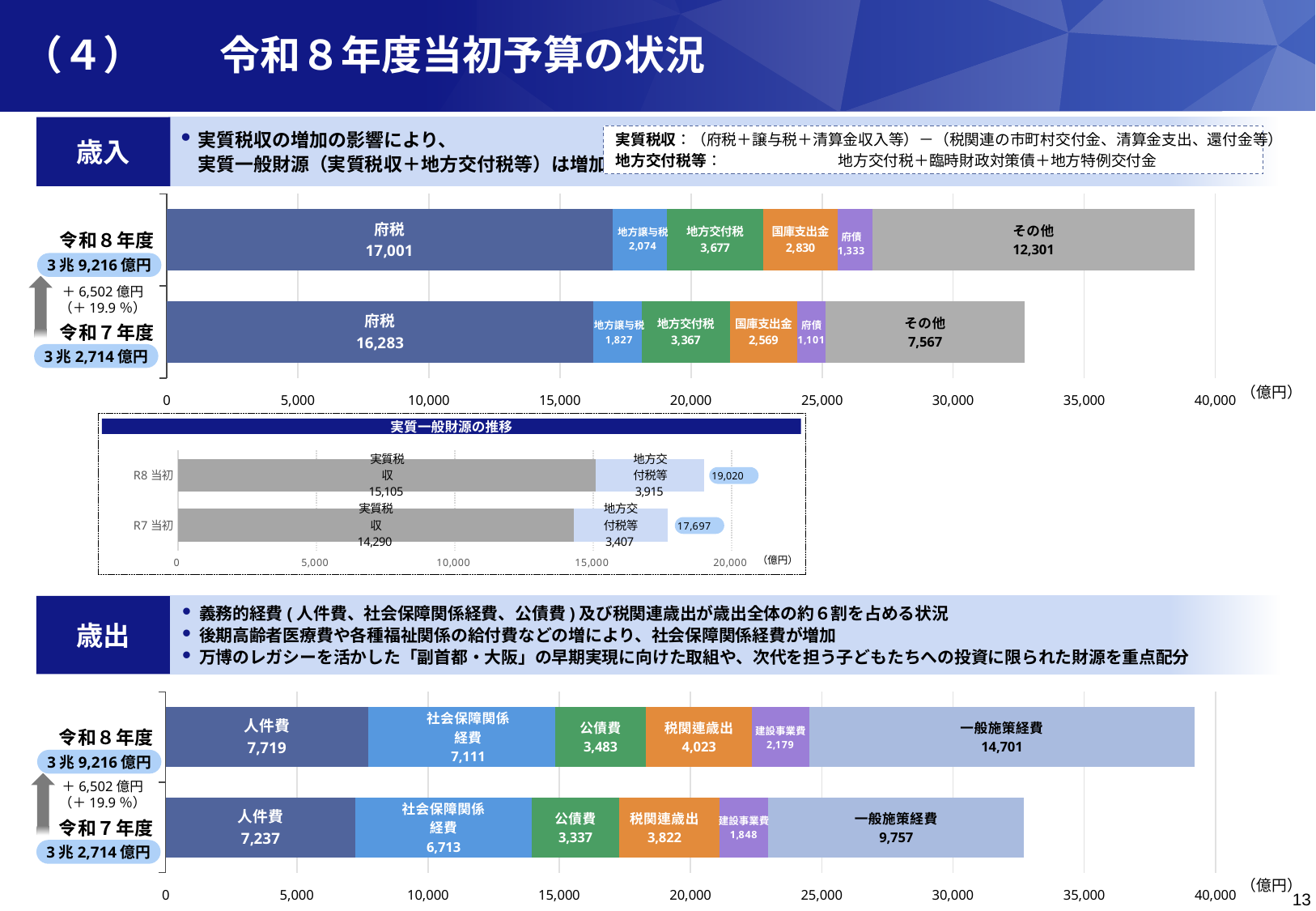
What kind of chart is the bottom expenditure (歳出) chart? Stacked bar chart In the bottom expenditure (歳出) chart, which is larger: 公債費 for 令和8年度 or 税関連歳出 for 令和8年度? 税関連歳出 for 令和8年度 In the top revenue (歳入) chart, which segment of the 令和8年度 bar is the largest? 府税 In the bottom expenditure (歳出) chart, what is the difference between 一般施策経費 for 令和8年度 and 令和7年度? 4,944 In the 実質一般財源の推移 chart, what is the total for R8 当初? 19,020 In the top revenue (歳入) chart, which segment of the 令和7年度 bar is the smallest? 府債 In the 実質一般財源の推移 chart, what is the value of 地方交付税等 for R7 当初? 3,407 In the top revenue (歳入) chart, what is the value of その他 for 令和7年度? 7,567 In the bottom expenditure (歳出) chart, what is the value of 社会保障関係経費 for 令和8年度? 7,111 In the top revenue (歳入) chart, what is the difference between 府税 for 令和8年度 and 府税 for 令和7年度? 718 In the top revenue (歳入) chart, what is the value of 府税 for 令和8年度? 17,001 In the bottom expenditure (歳出) chart, how many segments make up each bar? 6